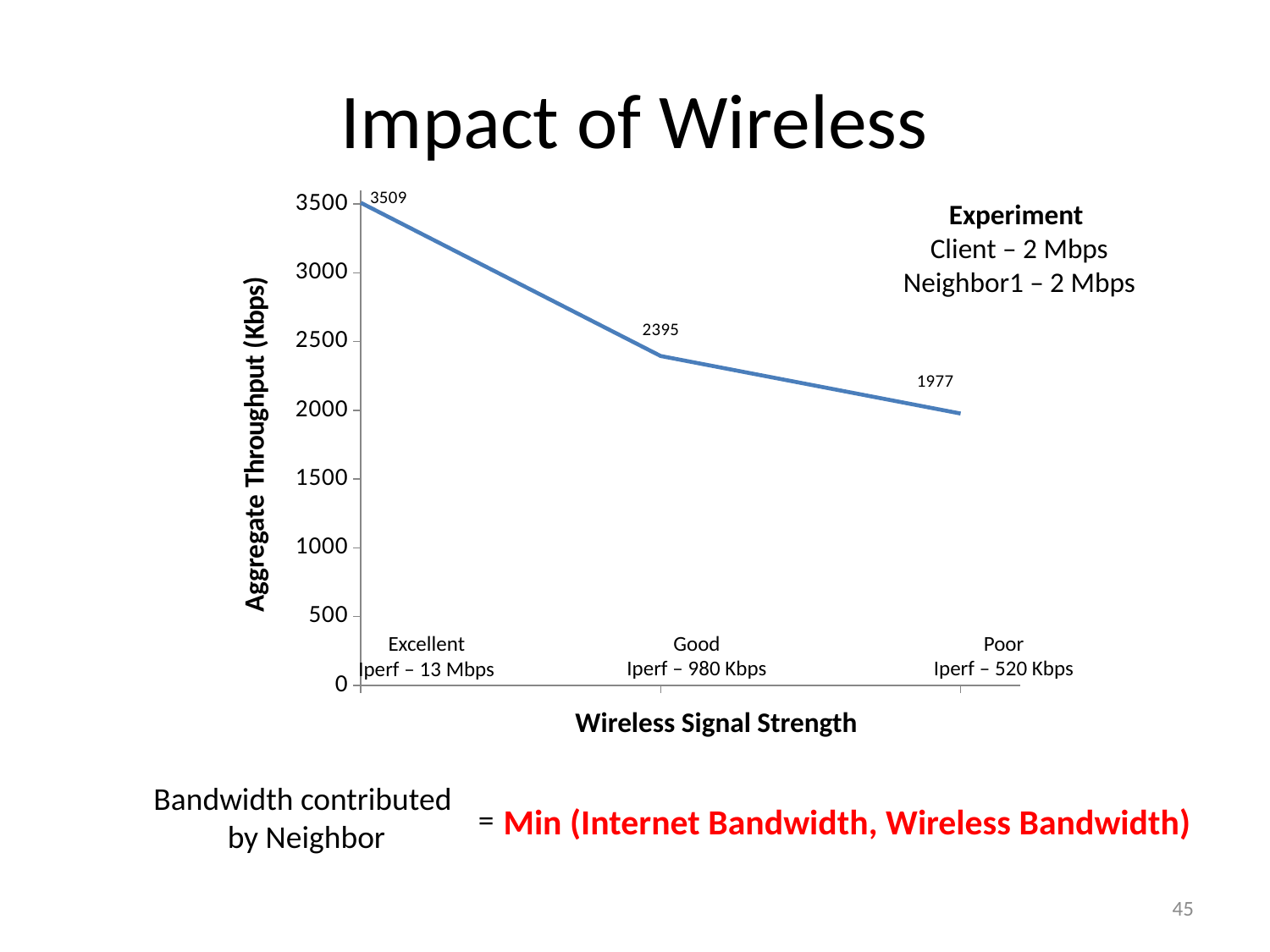
Which has a larger aggregate throughput, Good or Poor signal strength? Good Which wireless signal strength has the lowest aggregate throughput? Poor What is the aggregate throughput for the Good wireless signal strength? 2395 Does the aggregate throughput rise or fall as the wireless signal strength goes from Excellent to Poor? fall What kind of chart is shown on the slide? line chart What is the difference in aggregate throughput between Good and Poor signal strength? 418 What is the aggregate throughput for the Poor wireless signal strength? 1977 Is the aggregate throughput for Poor signal strength greater or less than 2000? less How many wireless signal strength categories are plotted on the chart? 3 Which wireless signal strength has the highest aggregate throughput? Excellent What is the difference in aggregate throughput between Excellent and Good signal strength? 1114 What is the aggregate throughput for the Excellent wireless signal strength? 3509